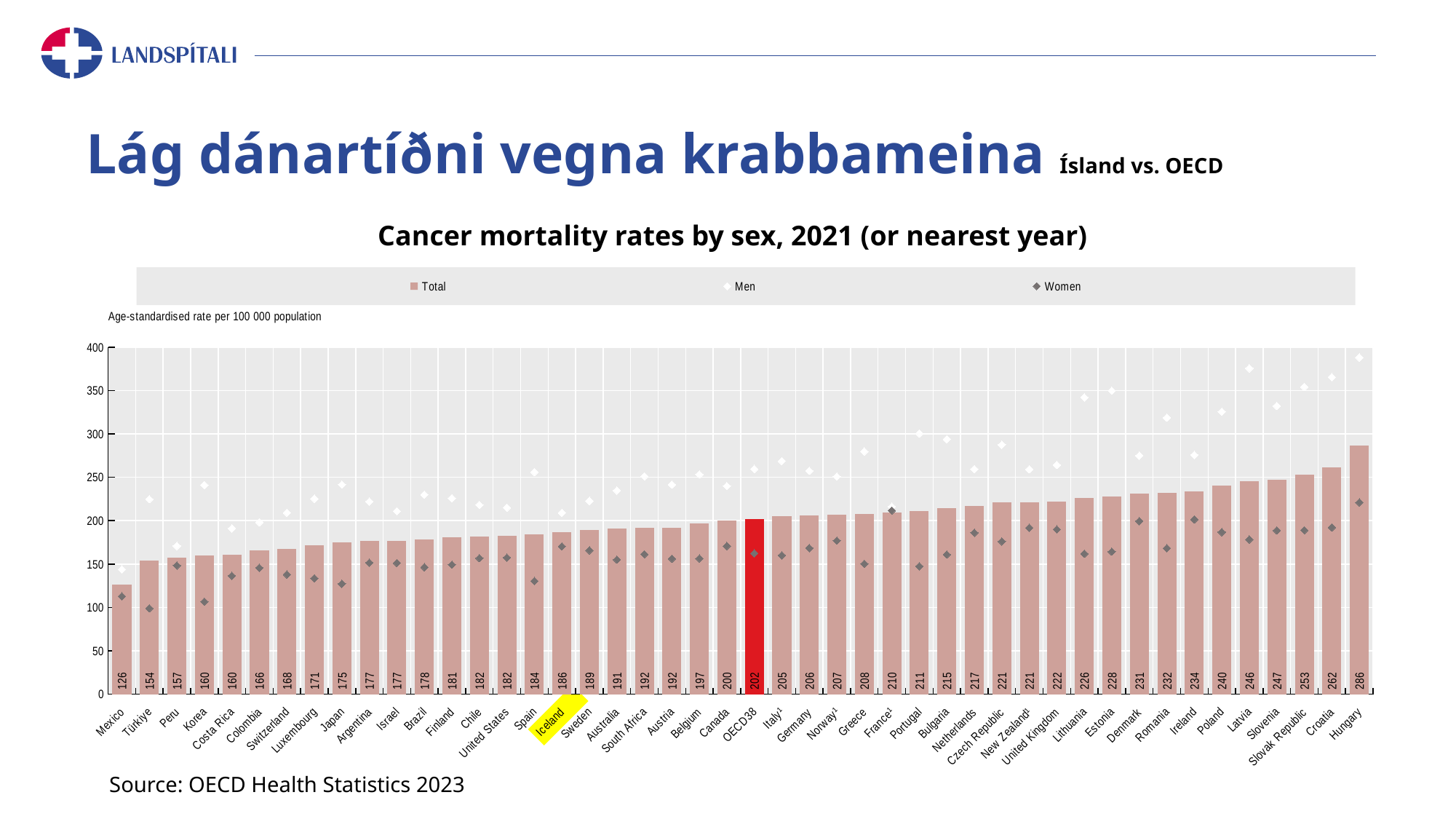
What is the Total value shown for OECD38? 202 How many countries or groups are shown on the x axis? 46 Is the Men value for Hungary greater or less than 350? greater How many series does the legend list? 3 Which country has the lowest Total cancer mortality rate? Mexico What is the Total value shown for Hungary? 286 What is the Total cancer mortality rate for Iceland? 186 Which country has the highest Total cancer mortality rate? Hungary Which has a higher Total value, Iceland or Sweden? Sweden What kind of chart is shown on the slide? Bar chart Do the Total values rise or fall from left to right along the x axis? Rise What is the difference between the Total values for OECD38 and Iceland? 16